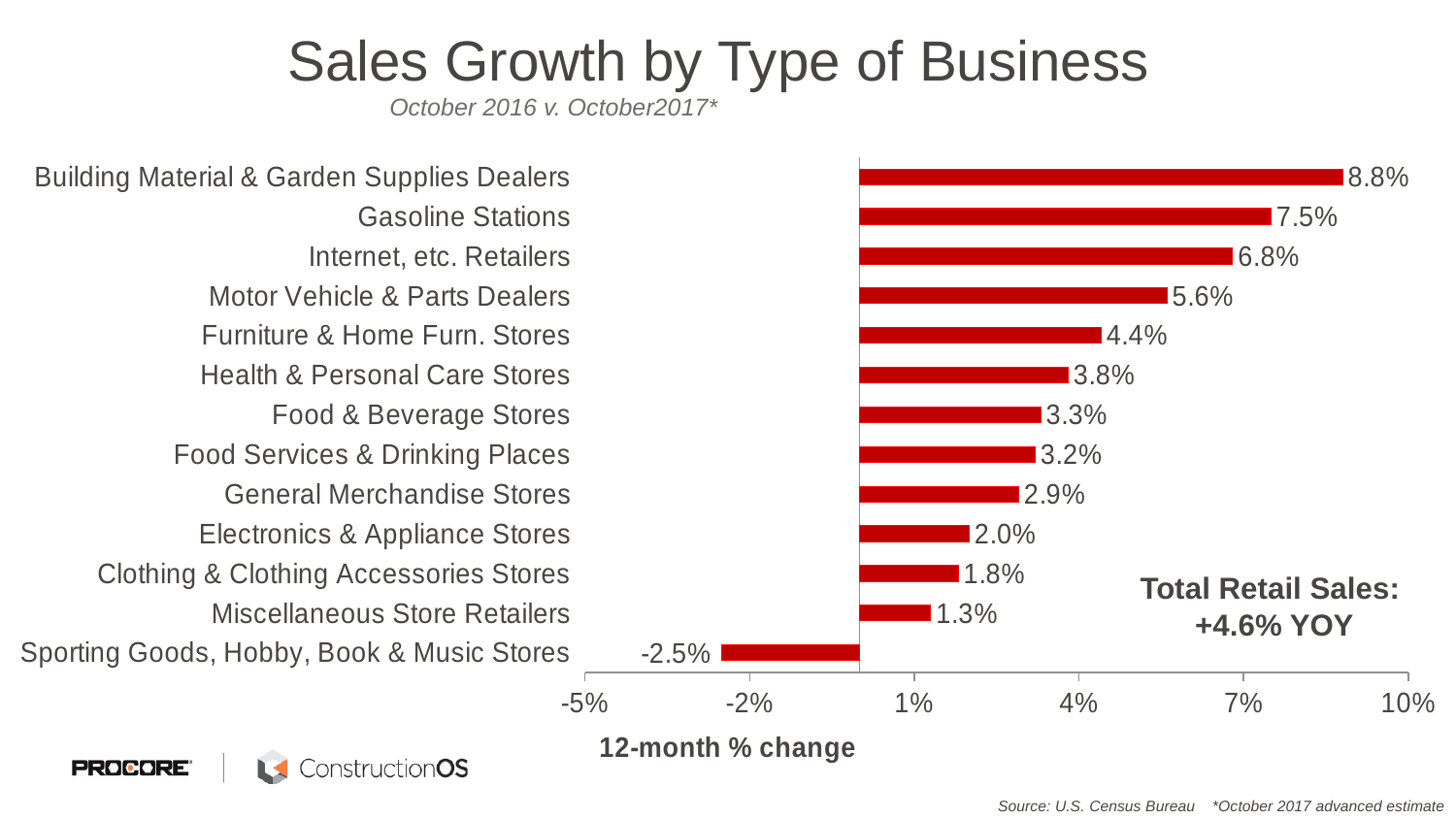
What is the sales growth value for Sporting Goods, Hobby, Book & Music Stores? -2.5% How many types of business are shown in the chart? 13 Which has higher sales growth, Electronics & Appliance Stores or General Merchandise Stores? General Merchandise Stores Which type of business has the highest sales growth? Building Material & Garden Supplies Dealers What is the difference between the sales growth of Internet, etc. Retailers and Motor Vehicle & Parts Dealers? 1.2% What is the sales growth value for Gasoline Stations? 7.5% Is the value for Furniture & Home Furn. Stores greater or less than 4%? greater Which type of business has the lowest sales growth? Sporting Goods, Hobby, Book & Music Stores What is the title of the chart? Sales Growth by Type of Business What is the label on the horizontal axis? 12-month % change What is the sales growth value for Health & Personal Care Stores? 3.8% What kind of chart is shown on the slide? Bar chart